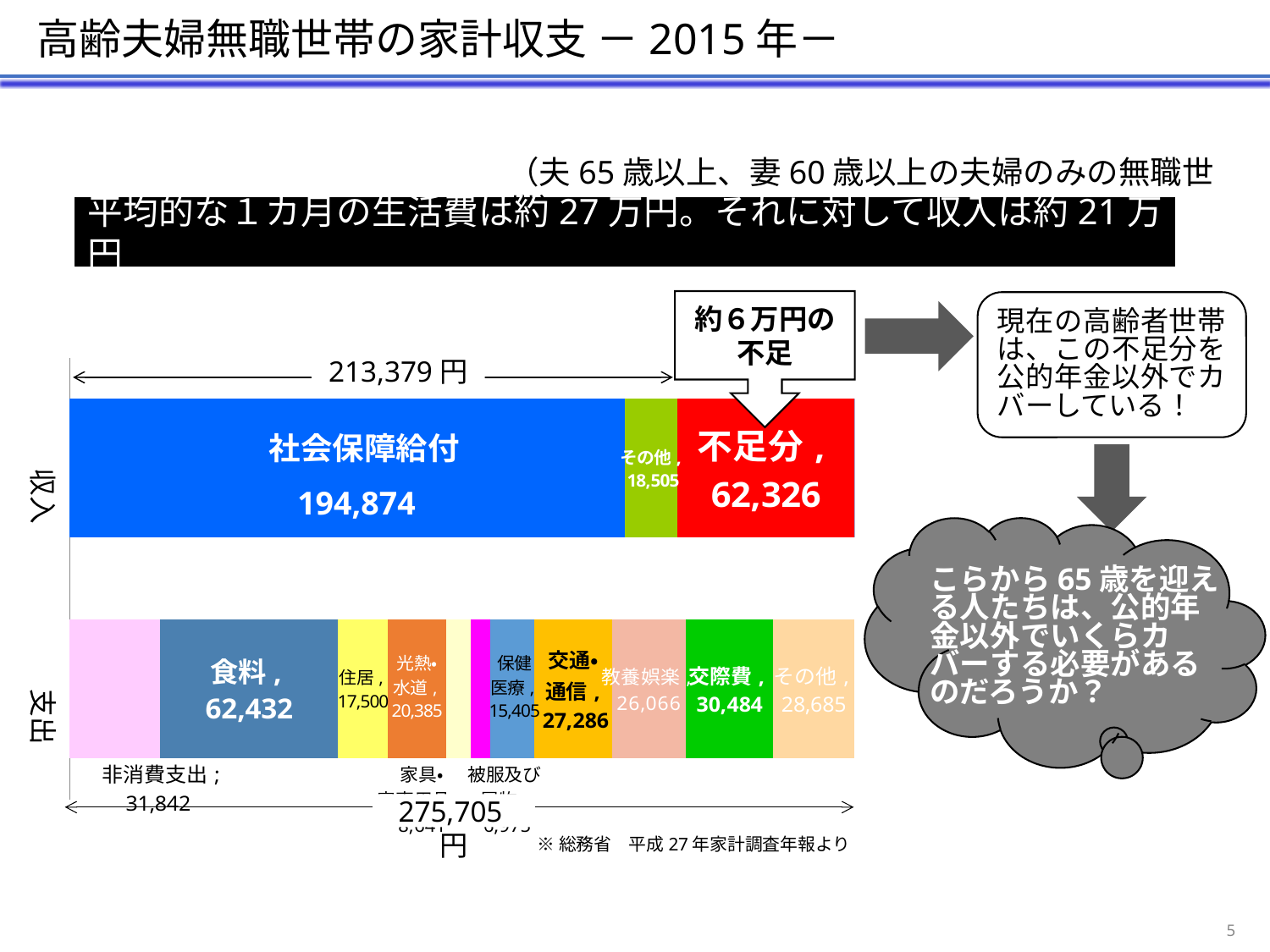
What is the difference between 食料 (62,432) and 住居 (17,500) in the 支出 bar? 44,932 What is the value of 不足分 in the 収入 bar? 62,326 What is the value of 交通・通信 in the 支出 bar? 27,286 What is the value of 社会保障給付 in the 収入 bar? 194,874 What is the total income shown by the arrow above the 収入 bar? 213,379 円 What is the value of 交際費 in the 支出 bar? 30,484 Which is larger in the 支出 bar, 交際費 or 教養娯楽? 交際費 What is the value of 食料 in the 支出 bar? 62,432 What is the value of その他 in the 収入 bar? 18,505 Which segment is the largest in the 収入 bar? 社会保障給付 What is the total expenditure shown by the arrow below the 支出 bar? 275,705 円 What kind of chart is shown on the slide? Stacked bar chart